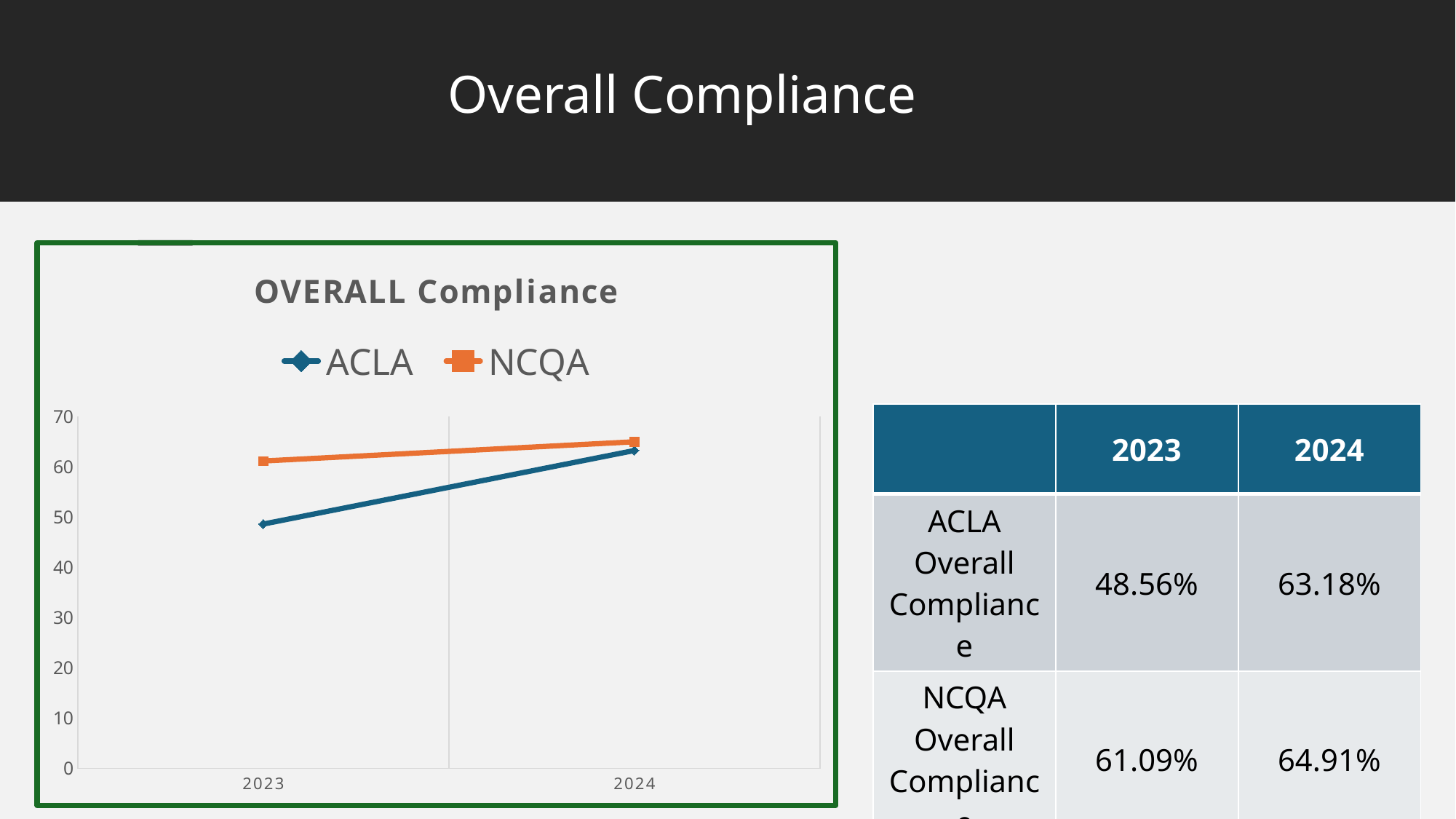
According to the table on the slide, what is the NCQA Overall Compliance value for 2023? 61.09% Does the NCQA line rise or fall from 2023 to 2024? rise How many series does the chart legend list? 2 Is the NCQA value for 2023 greater or less than 60? greater Which series has the higher value in 2023, ACLA or NCQA? NCQA Which series is drawn in orange in the chart? NCQA What is the title of the chart? OVERALL Compliance According to the table on the slide, what is the ACLA Overall Compliance value for 2024? 63.18% How many points are on the x axis of the chart? 2 What type of chart is shown on the slide? line chart Is the ACLA value for 2023 greater or less than 50? less Does the ACLA line rise or fall from 2023 to 2024? rise